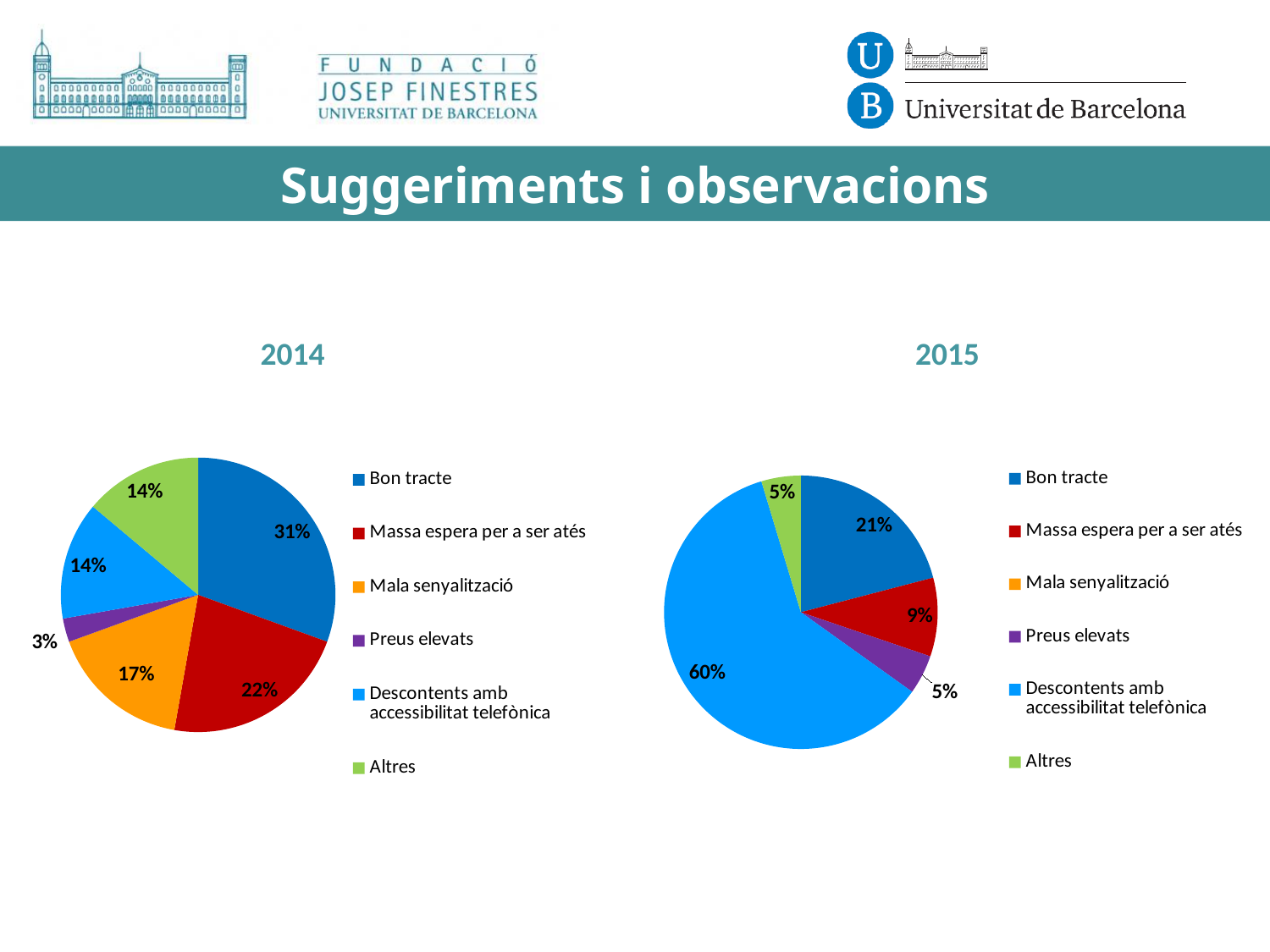
In the 2015 chart, which is larger, Massa espera per a ser atés or Preus elevats? Massa espera per a ser atés What kind of chart is the 2014 chart? pie chart In the 2015 chart, what is the difference between Descontents amb accessibilitat telefònica and Bon tracte? 39% In the 2015 chart, what share does Bon tracte have? 21% In the 2014 chart, what share does Bon tracte have? 31% In the 2014 chart, what is the difference between Bon tracte and Massa espera per a ser atés? 9% In the 2014 chart, what share does Mala senyalització have? 17% In the 2014 chart, which category has the largest slice? Bon tracte How many entries does the legend of the 2014 chart list? 6 In the 2015 chart, what share does Descontents amb accessibilitat telefònica have? 60% In the 2015 chart, which category has the largest slice? Descontents amb accessibilitat telefònica In the 2014 chart, which category has the smallest slice? Preus elevats